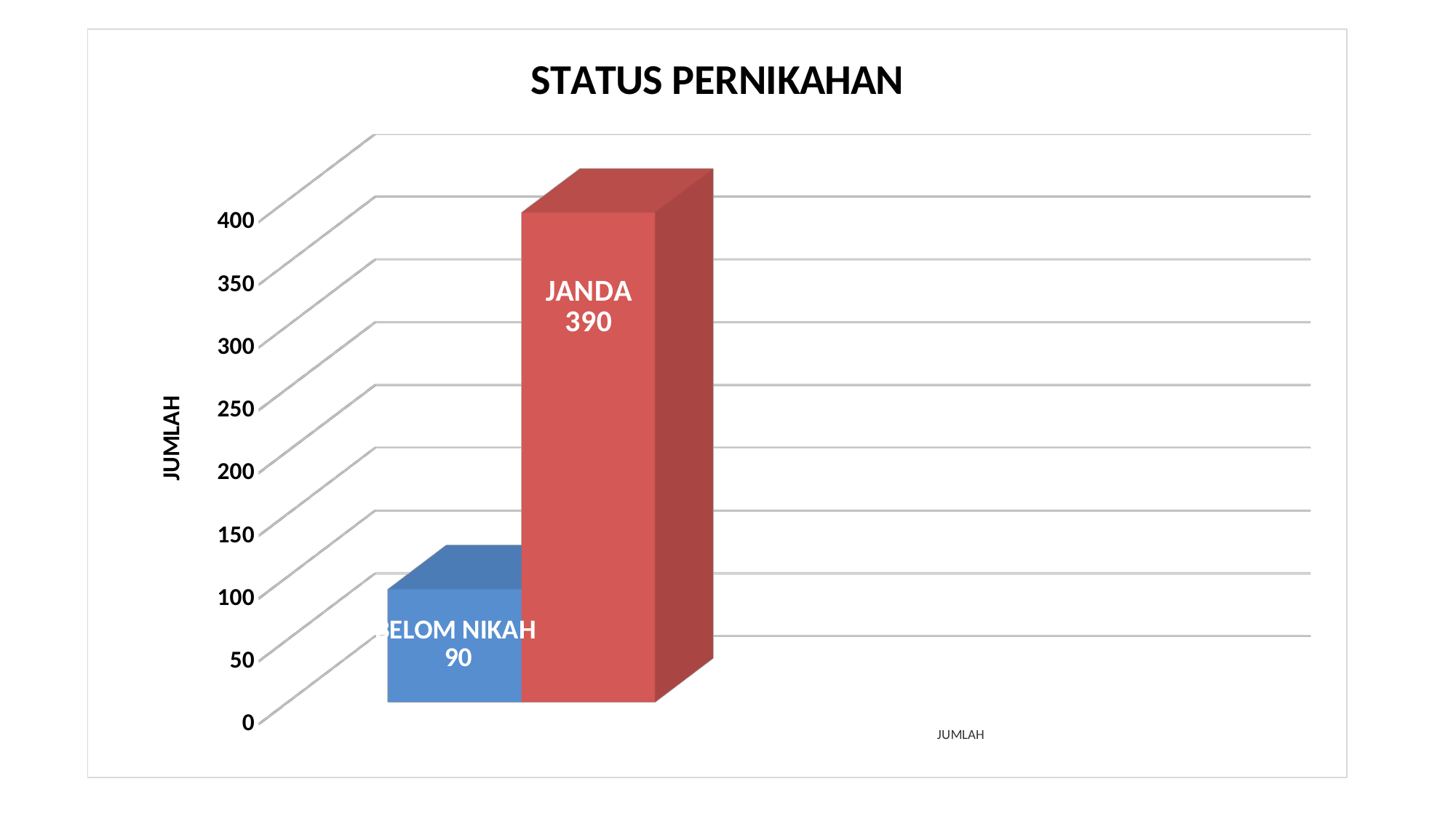
Is the value for BELOM NIKAH greater or less than 100? less What is the value for BELOM NIKAH? 90 Which is larger, the value for JANDA or the value for BELOM NIKAH? JANDA How many categories are shown in the chart? 2 What is the title of the chart? STATUS PERNIKAHAN What is the label on the vertical axis? JUMLAH What is the value for JANDA? 390 Is the value for JANDA greater or less than 350? greater What is the difference between the values for JANDA and BELOM NIKAH? 300 Which category has the lowest value? BELOM NIKAH What kind of chart is shown on the slide? bar chart Which category has the highest value? JANDA